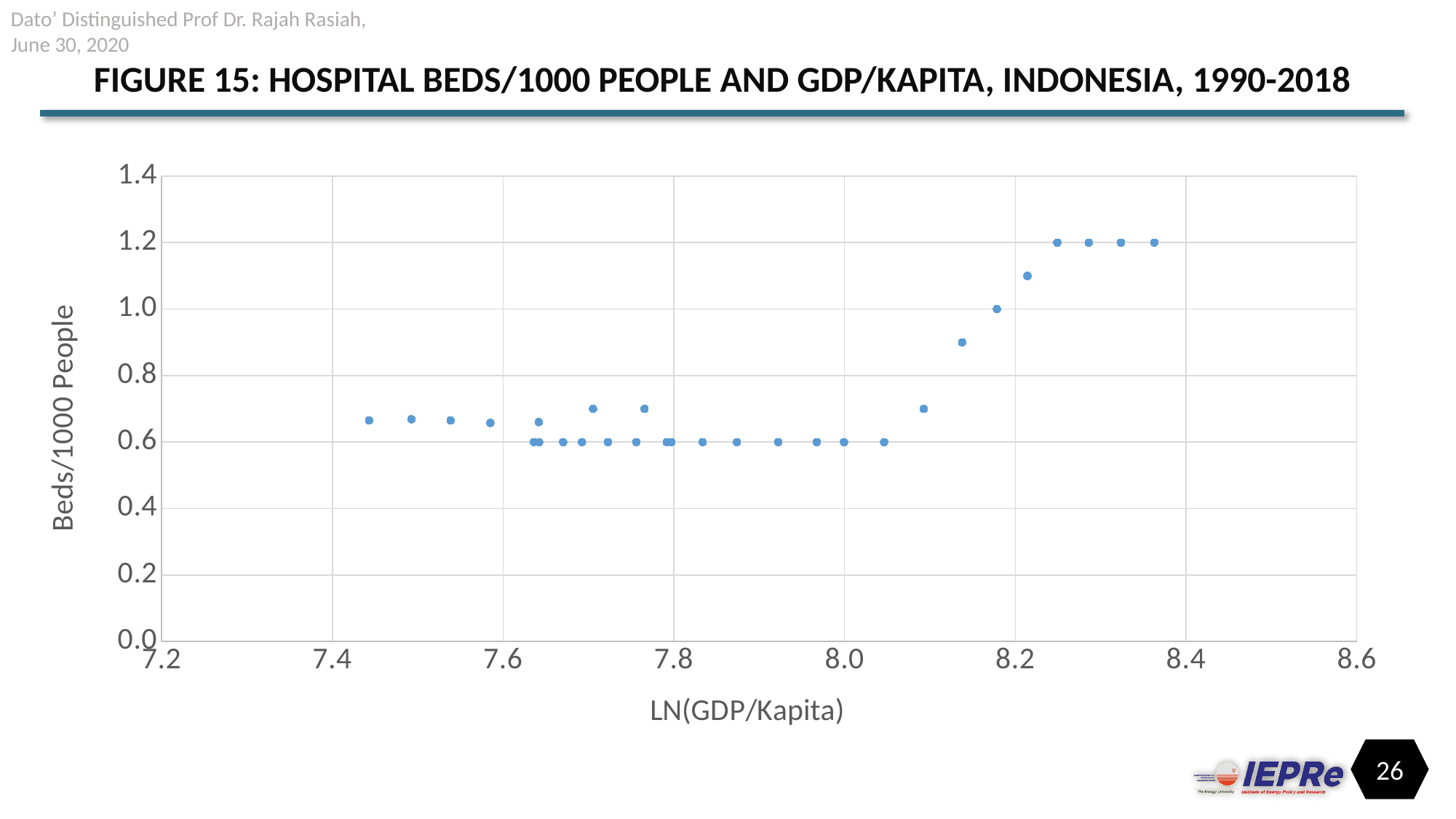
Is the Beds/1000 People value for the point at LN(GDP/Kapita) of about 8.14 greater or less than 0.8? greater Overall, do the Beds/1000 People values rise or fall as LN(GDP/Kapita) increases along the x axis? rise Is the Beds/1000 People value for the leftmost point greater or less than 0.6? greater What kind of chart is shown on the slide? Scatter chart What is the lowest Beds/1000 People value reached by any point on the chart? 0.6 What is the title of the chart? FIGURE 15: HOSPITAL BEDS/1000 PEOPLE AND GDP/KAPITA, INDONESIA, 1990-2018 What is the highest Beds/1000 People value reached by any point on the chart? 1.2 Is the Beds/1000 People value for the point at LN(GDP/Kapita) of about 8.09 greater or less than 0.8? less What is the label of the horizontal axis? LN(GDP/Kapita) Which has the higher Beds/1000 People value: the rightmost point or the leftmost point? the rightmost point What is the Beds/1000 People value of the rightmost point on the chart? 1.2